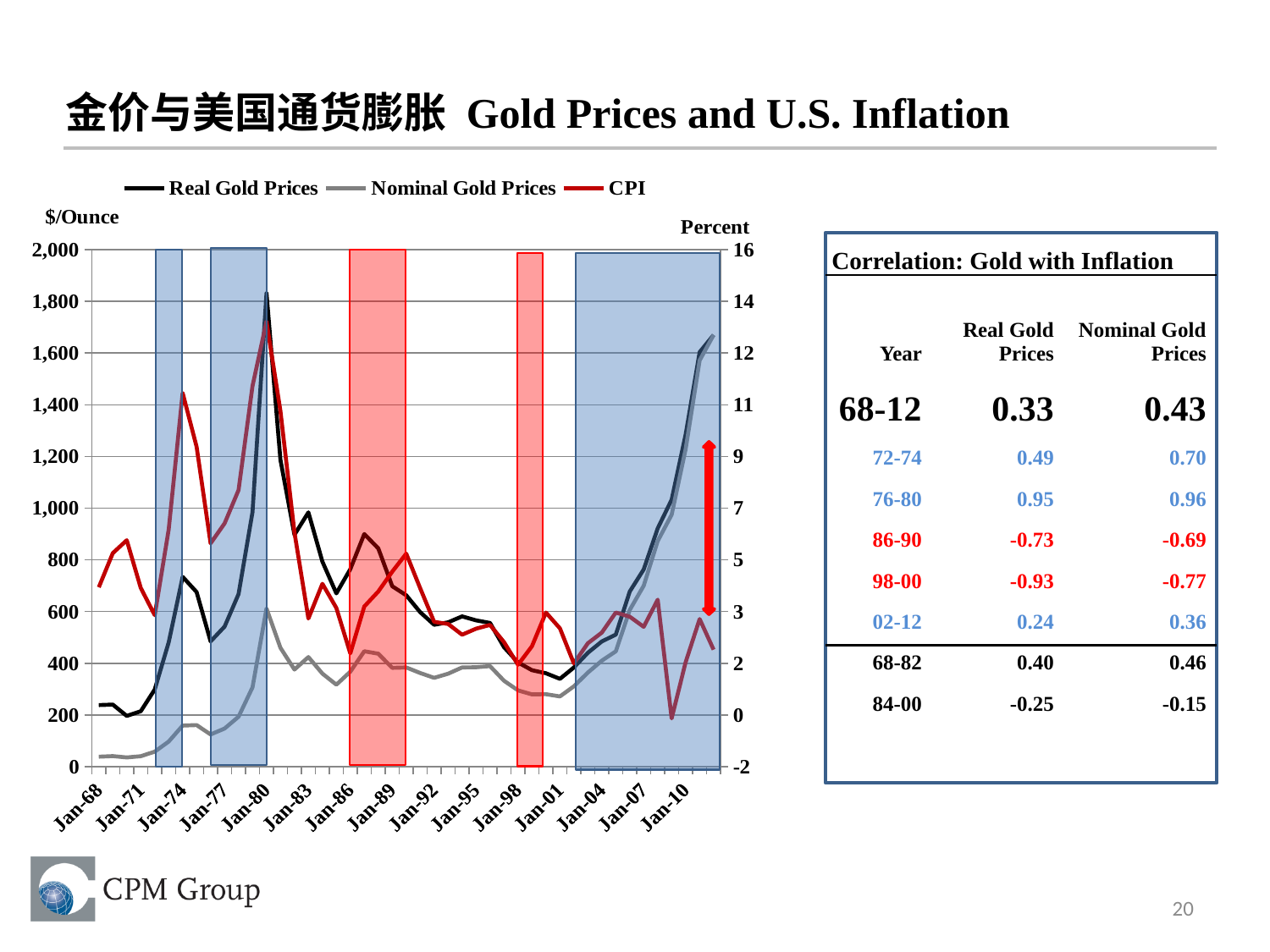
What is the label on the right vertical axis of the chart? Percent How many date labels are shown along the x axis of the chart? 15 Is the value of Nominal Gold Prices at Jan-10 greater or less than 1,400 $/Ounce? less Do Nominal Gold Prices rise or fall between Jan-01 and Jan-10? rise Is the CPI value at its peak around Jan-80 greater or less than 9 percent? greater How many series does the chart legend list? 3 Is the value of Real Gold Prices at Jan-68 greater or less than 400 $/Ounce? less Which gold price series reaches the highest value on the left axis over the whole chart? Real Gold Prices At Jan-68, which is higher: Real Gold Prices or Nominal Gold Prices? Real Gold Prices What is the label on the left vertical axis of the chart? $/Ounce What kind of chart is shown on the slide? line chart